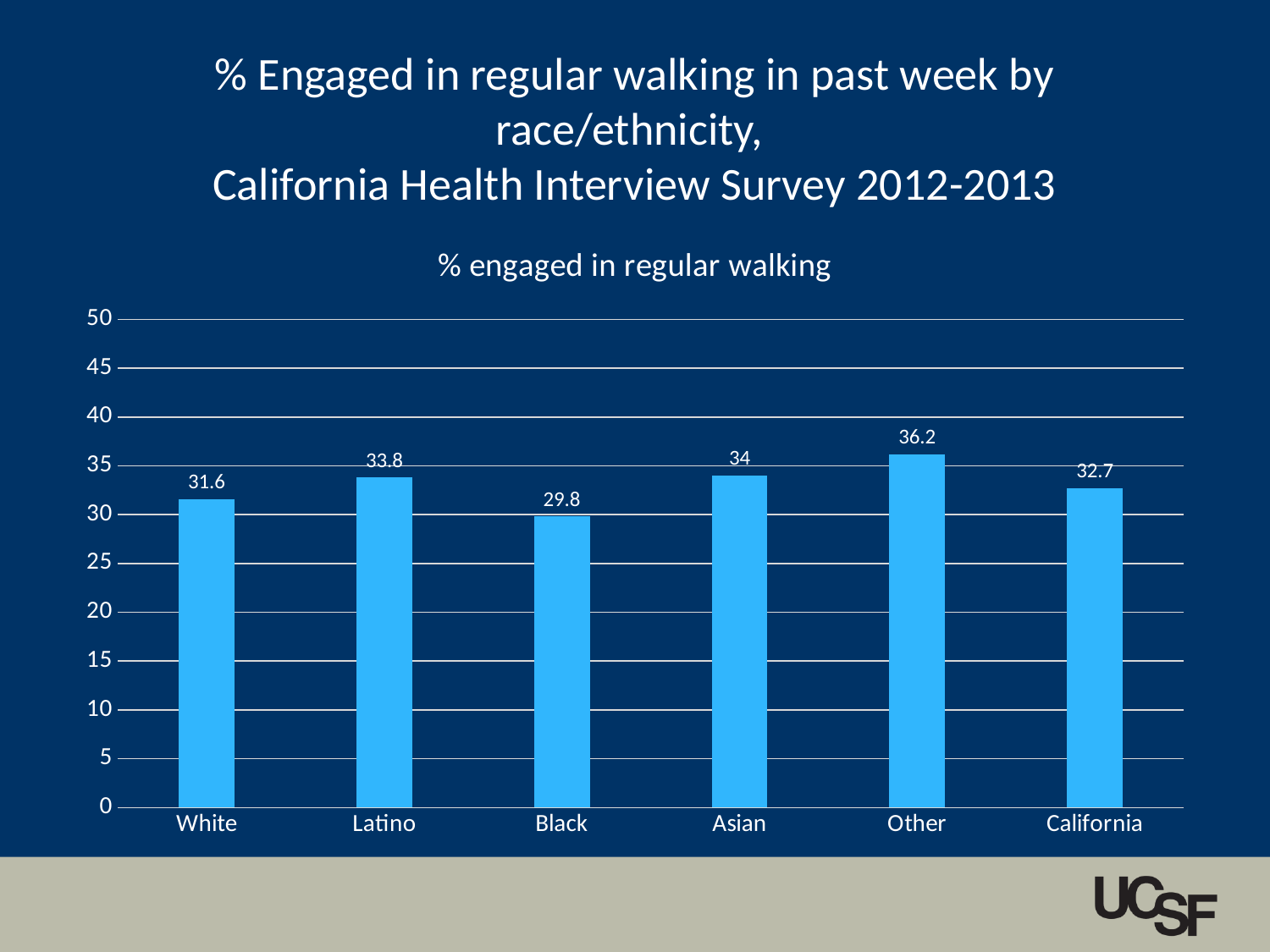
Which category has the lowest value? Black What is the value for White? 31.6 What is the title of the chart? % engaged in regular walking What is the difference between the values for Latino and White? 2.2 Which category has the highest value? Other Is the value for Black greater or less than 30? less What is the value for Black? 29.8 What kind of chart is shown? bar chart What is the value for California? 32.7 Which is larger, the value for Asian or the value for Latino? Asian How many categories are shown on the x axis? 6 What is the difference between the values for Other and Black? 6.4